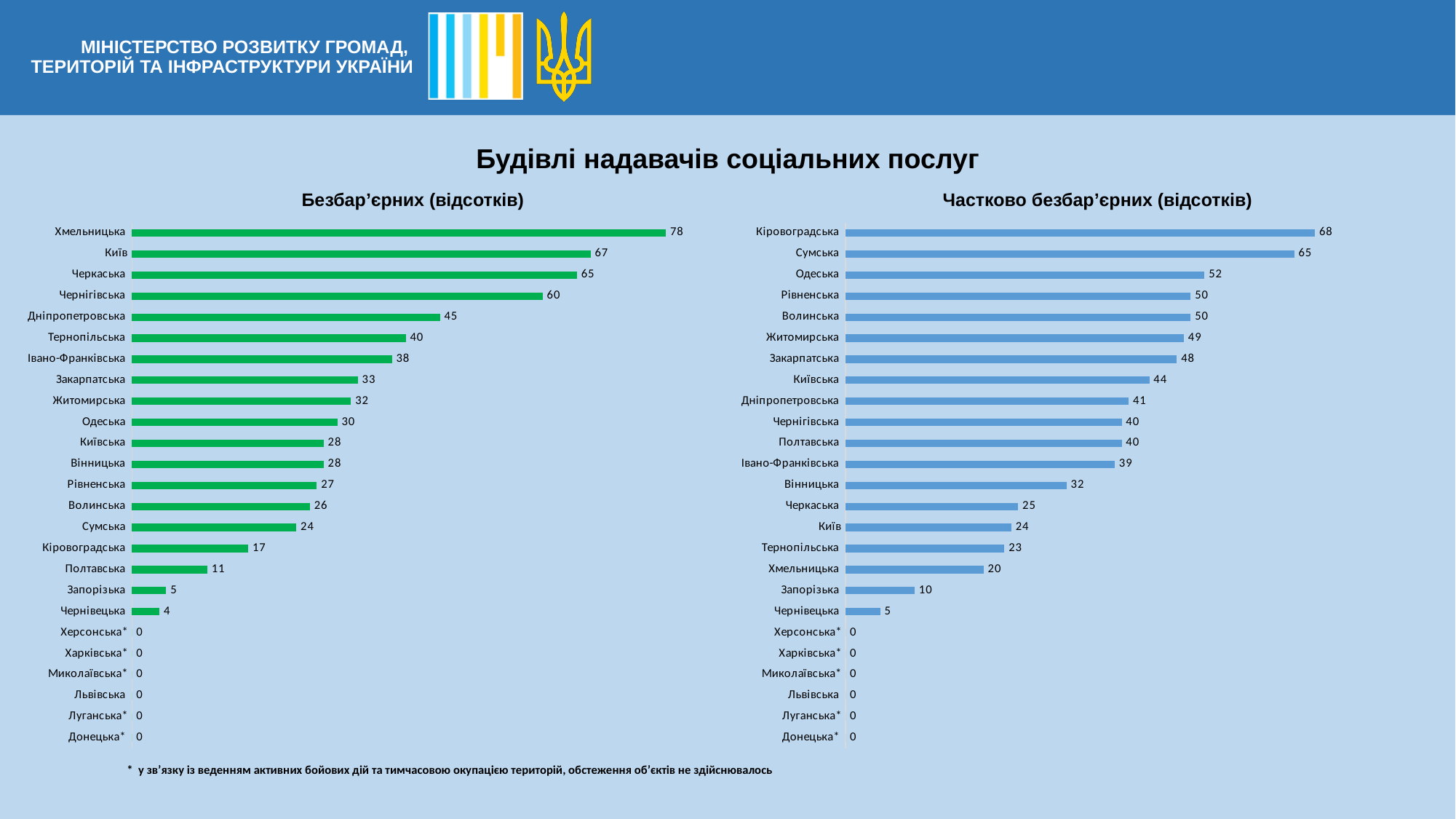
In the chart 'Частково безбар’єрних (відсотків)', what is the value for Одеська? 52 In the chart 'Частково безбар’єрних (відсотків)', which region has the highest value? Кіровоградська In the chart 'Безбар’єрних (відсотків)', what is the value for Хмельницька? 78 What type of chart is 'Частково безбар’єрних (відсотків)'? Bar chart In the chart 'Безбар’єрних (відсотків)', what is the value for Полтавська? 11 In the chart 'Частково безбар’єрних (відсотків)', what is the difference between the values for Кіровоградська and Хмельницька? 48 In the chart 'Безбар’єрних (відсотків)', which region has the highest value? Хмельницька In the chart 'Частково безбар’єрних (відсотків)', which is larger: the value for Київ or the value for Вінницька? Вінницька In the chart 'Безбар’єрних (відсотків)', which is larger: the value for Тернопільська or the value for Сумська? Тернопільська How many regions are listed in the chart 'Безбар’єрних (відсотків)'? 25 What is the main title shown above the two charts on the slide? Будівлі надавачів соціальних послуг In the chart 'Безбар’єрних (відсотків)', what is the difference between the values for Київ and Черкаська? 2